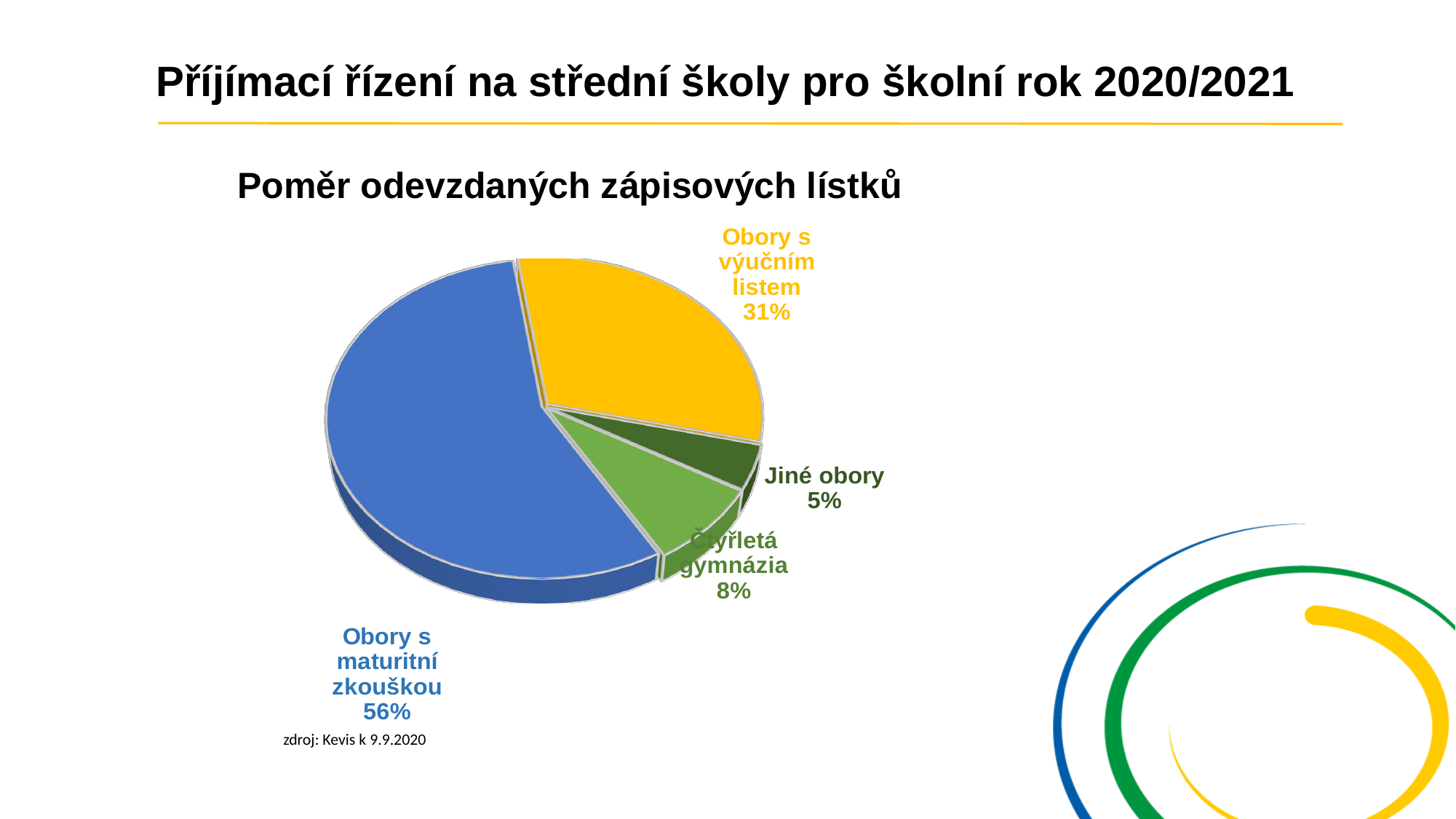
What share of the pie is 'Obory s výučním listem'? 31% What share of the pie is 'Jiné obory'? 5% What share of the pie is 'Obory s maturitní zkouškou'? 56% What is the title of the chart? Poměr odevzdaných zápisových lístků What colour is the slice for 'Obory s výučním listem'? yellow What is the difference in percentage points between 'Obory s maturitní zkouškou' and 'Obory s výučním listem'? 25 Which category has the largest share of the pie? Obory s maturitní zkouškou Which category has the smallest share of the pie? Jiné obory What kind of chart is shown on the slide? pie chart How many slices does the pie chart have? 4 Which is larger, the share for 'Čtyřletá gymnázia' or the share for 'Jiné obory'? Čtyřletá gymnázia